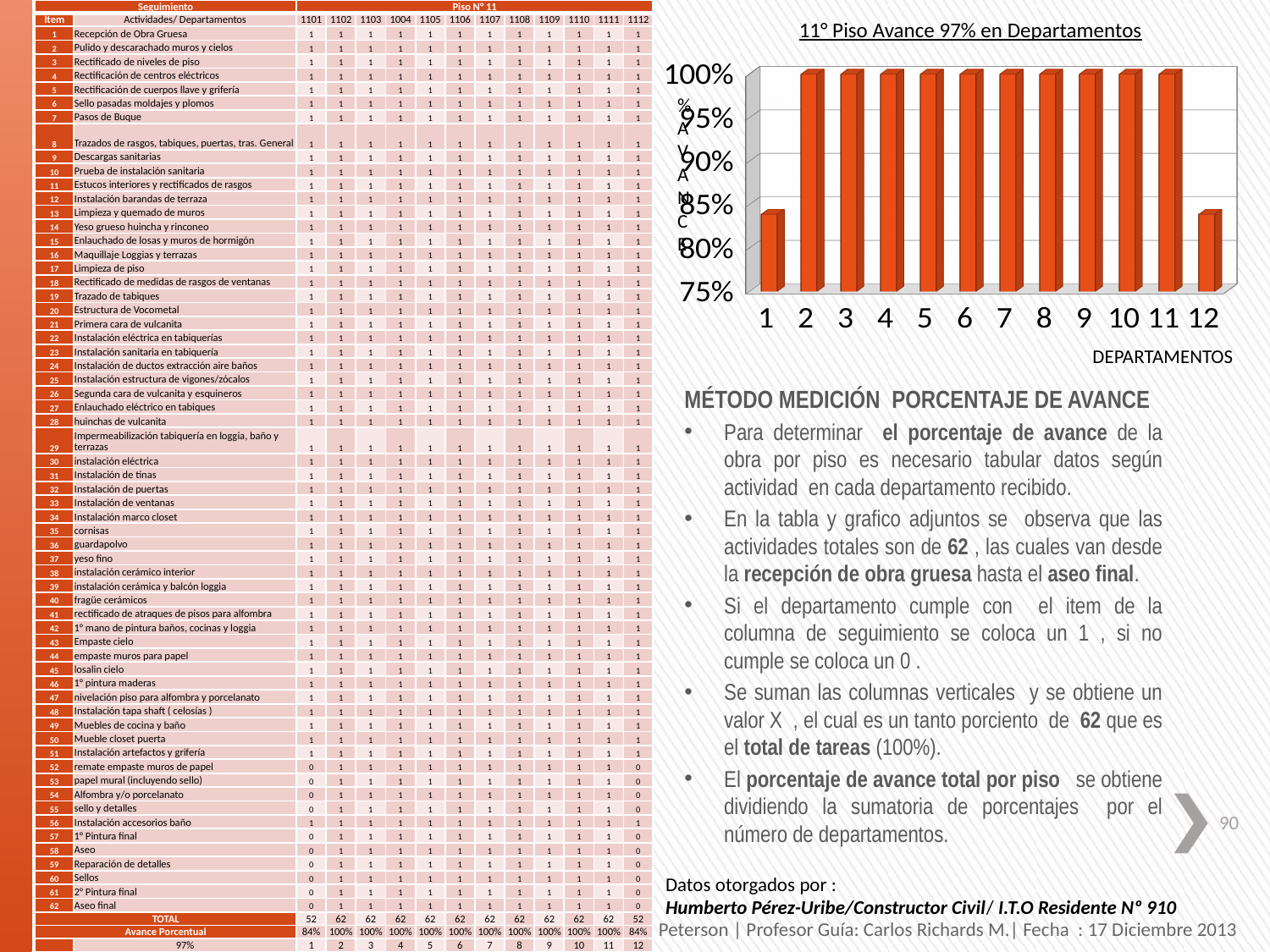
What is the label of the x axis of the chart? DEPARTAMENTOS Which two departments have the lowest values in the chart? 1 and 12 Is the value for department 1 greater or less than 90%? less What kind of chart is shown on the slide? bar chart How many departments (bars) are plotted in the chart? 12 Is the value for department 12 greater or less than 80%? greater What is the title of the chart? 11° Piso Avance 97% en Departamentos What is the value for department 5 in the chart? 100% What is the value for department 11 in the chart? 100% Which has the larger value, department 1 or department 2? department 2 How many departments reach 100% in the chart? 10